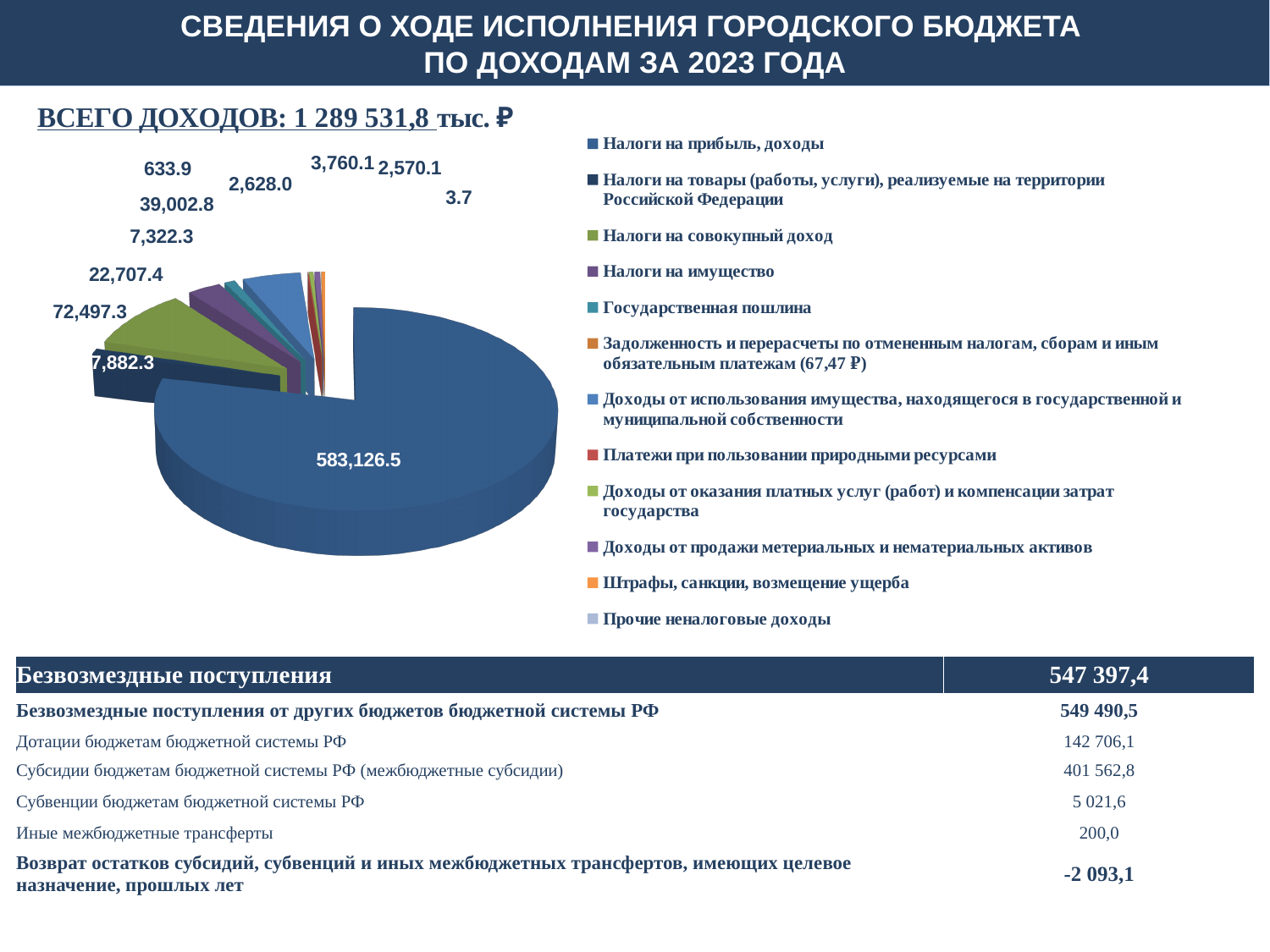
How many entries does the chart legend list? 12 Is the value of the largest slice greater or less than 500,000? greater What colour is the legend marker for 'Налоги на прибыль, доходы'? dark blue What is the smallest value printed as a data label on the pie chart? 3.7 What total income figure is printed above the pie chart? 1 289 531,8 тыс. ₽ How many data labels are printed on the pie chart? 11 What is the value printed on the largest slice of the pie chart? 583,126.5 What is the difference between the largest slice value 583,126.5 and the green slice value 72,497.3? 510,629.2 Which category does the largest slice of the pie chart represent? Налоги на прибыль, доходы What kind of chart is shown on the slide? pie chart What is the value printed on the green slice (Налоги на совокупный доход)? 72,497.3 Which is larger: the slice labelled 72,497.3 or the slice labelled 39,002.8? 72,497.3